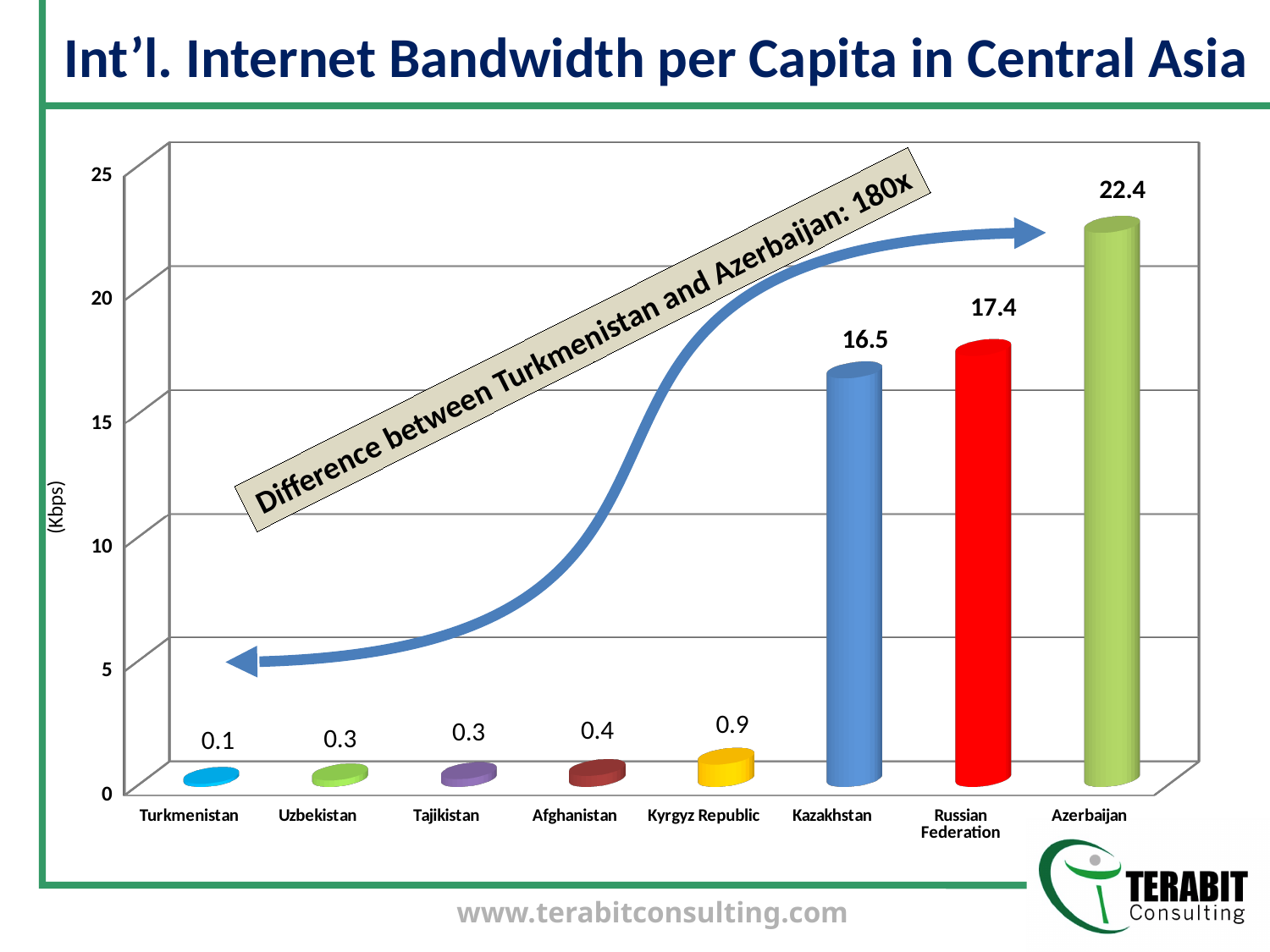
What is the difference between the values for Azerbaijan and the Russian Federation? 5.0 Is the value for Azerbaijan greater or less than 20? greater Which country has the lowest bandwidth per capita on the chart? Turkmenistan What kind of chart is shown on the slide? bar chart According to the annotation on the chart, what is the difference factor between Turkmenistan and Azerbaijan? 180x Which is larger, the value for Kazakhstan or the value for the Russian Federation? Russian Federation What is the difference between the values for Kazakhstan and the Kyrgyz Republic? 15.6 What is the value shown for the Russian Federation? 17.4 What is the value shown for the Kyrgyz Republic? 0.9 How many countries are shown on the chart? 8 What is the international Internet bandwidth per capita for Kazakhstan? 16.5 Which country has the highest bandwidth per capita on the chart? Azerbaijan